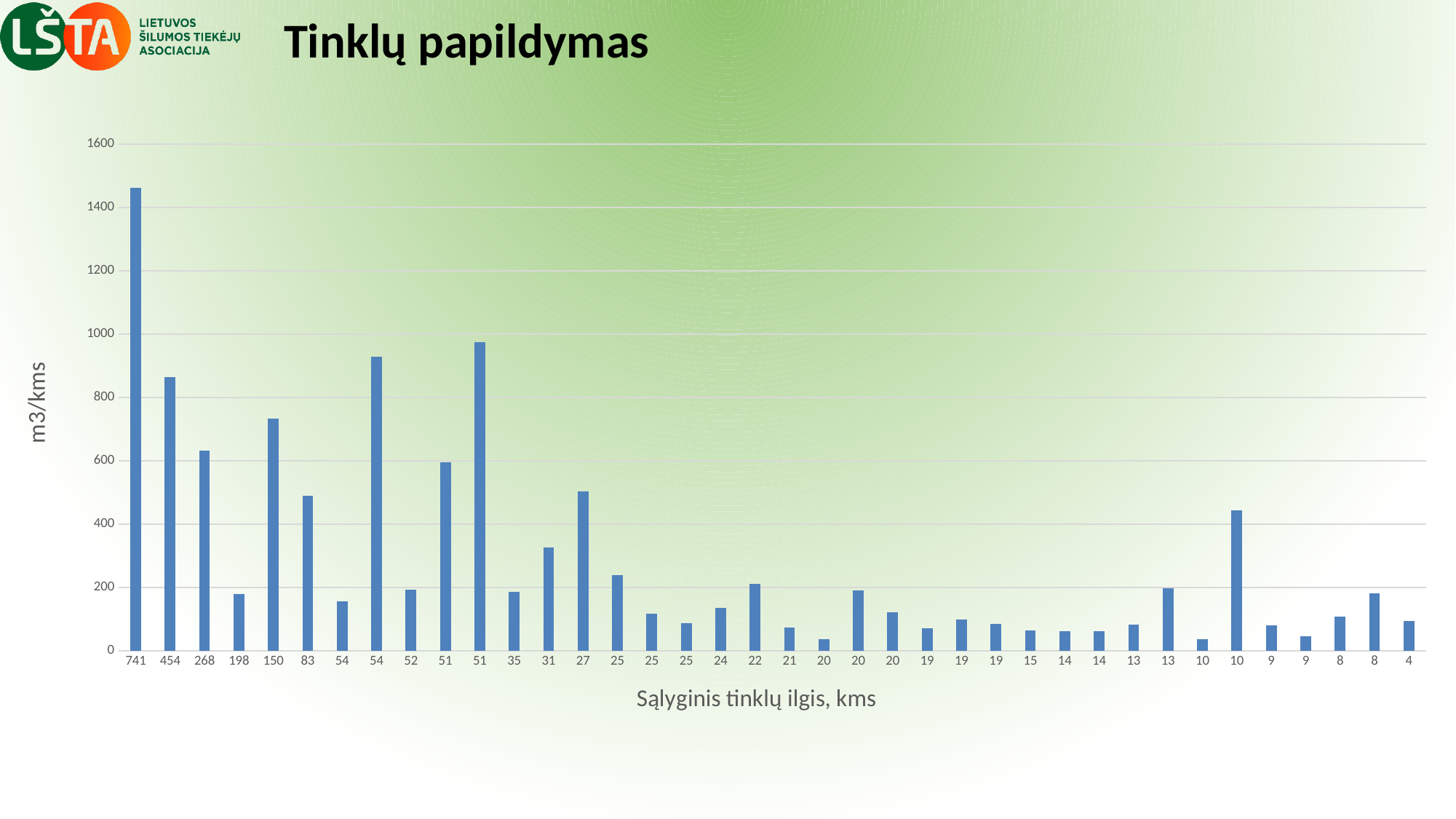
What is the title of the chart? Tinklų papildymas How many bars are plotted in the chart? 38 Is the value for category 150 greater or less than 600? greater What kind of chart is shown on the slide? bar chart Is the value for category 24 greater or less than 200? less Is the value for category 21 greater or less than 100? less Which category has the highest bar? 741 What is the label of the vertical axis? m3/kms Which has the larger value, category 454 or category 268? 454